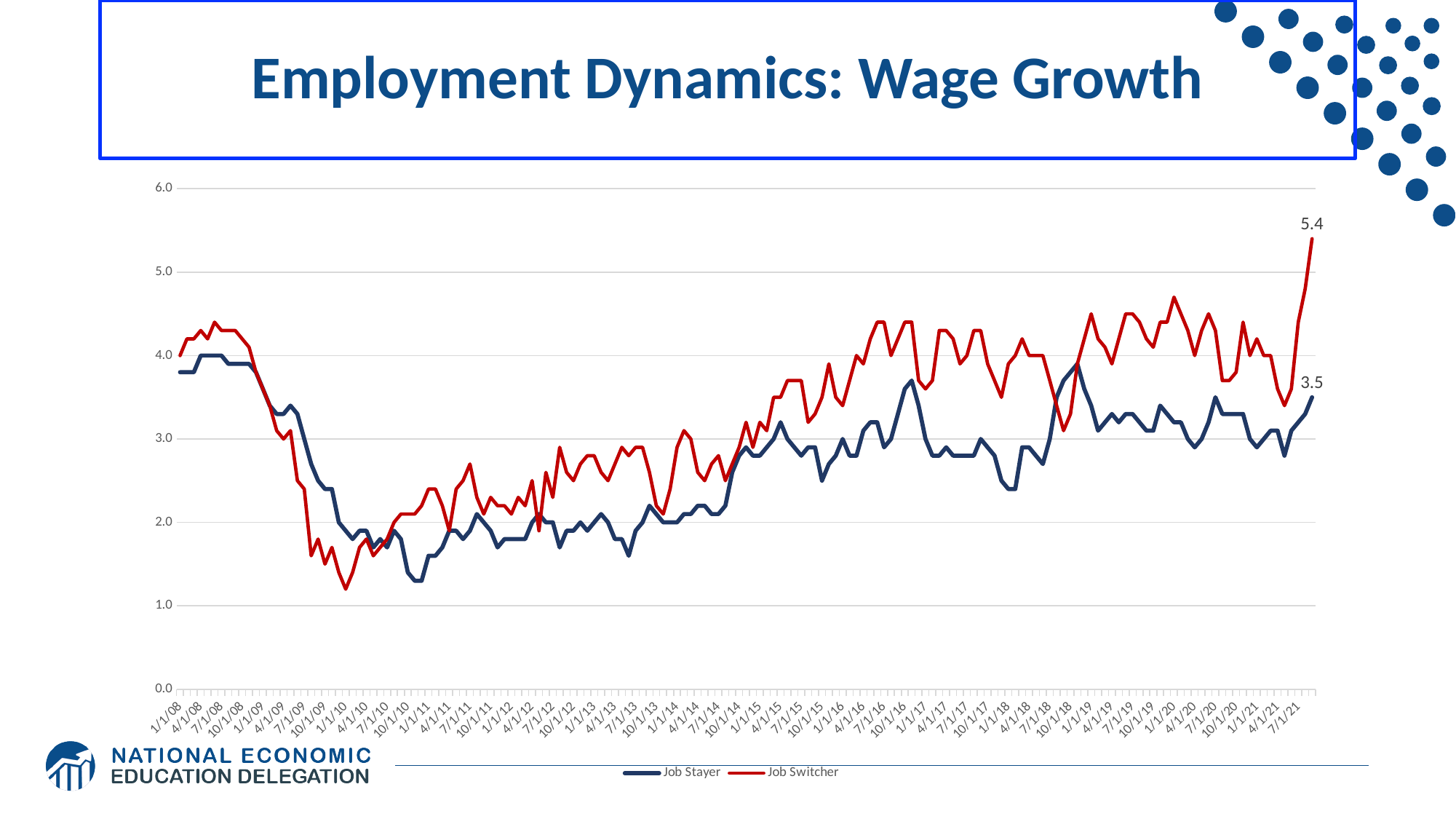
Is the value for Job Switcher at 1/1/20 greater or less than 4.0? greater Between 1/1/08 and 1/1/10, does the Job Stayer series rise or fall? fall Is the value for Job Switcher at 1/1/10 greater or less than 2.0? less What is the final labelled value for the Job Stayer series? 3.5 What kind of chart is shown on the slide? line chart At the last point on the chart, which series has the higher value, Job Stayer or Job Switcher? Job Switcher What is the title of the chart slide? Employment Dynamics: Wage Growth How many series does the legend list? 2 Is the value for Job Stayer at 1/1/08 greater or less than 3.0? greater What is the difference between the final labelled values of Job Switcher and Job Stayer? 1.9 What are the two series named in the legend? Job Stayer, Job Switcher What is the final labelled value for the Job Switcher series? 5.4